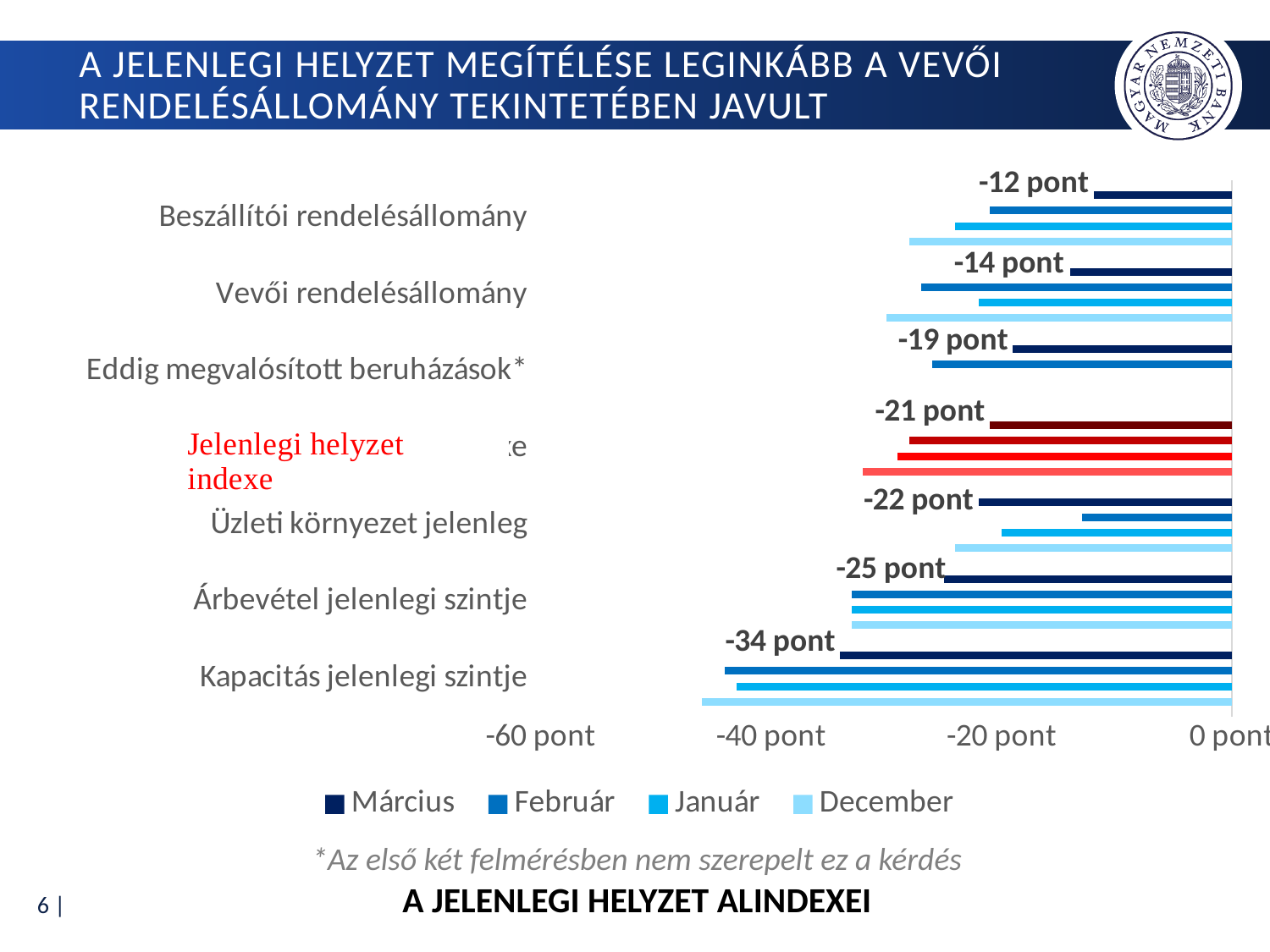
What is the Március value for Jelenlegi helyzet indexe? -21 pont Is the December value for Kapacitás jelenlegi szintje greater or less than -40 pont? less What is the difference between the Március values for Vevői rendelésállomány and Kapacitás jelenlegi szintje? 20 pont Which category has the highest Március value? Beszállítói rendelésállomány Which has a higher Március value: Eddig megvalósított beruházások or Üzleti környezet jelenleg? Eddig megvalósított beruházások How many series does the legend list? 4 Which category has the lowest Március value? Kapacitás jelenlegi szintje What is the Március value for Árbevétel jelenlegi szintje? -25 pont How many categories are shown in the chart? 7 What is the Március value for Kapacitás jelenlegi szintje? -34 pont What is the Március value for Beszállítói rendelésállomány? -12 pont What type of chart is shown on the slide? Bar chart